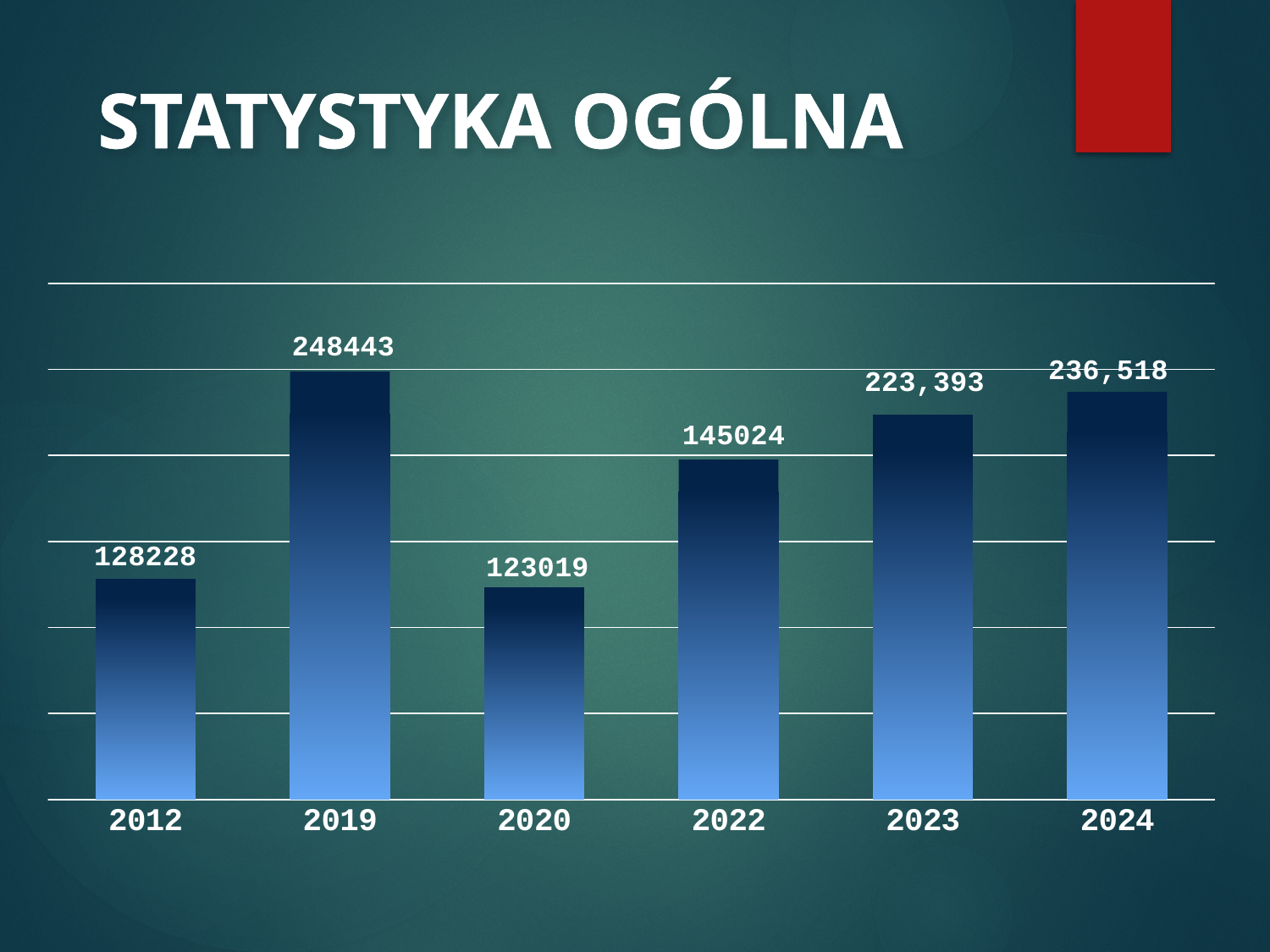
Which year has the lowest value? 2020 What is the difference between the values for 2024 and 2023? 13,125 How many years are shown on the chart? 6 What kind of chart is shown on the slide? bar chart What is the value for 2024? 236,518 What is the title of the slide? STATYSTYKA OGÓLNA Which year has the highest value? 2019 What is the value for 2020? 123019 What is the value for 2019? 248443 Which is larger, the value for 2012 or the value for 2022? 2022 What is the value for 2023? 223,393